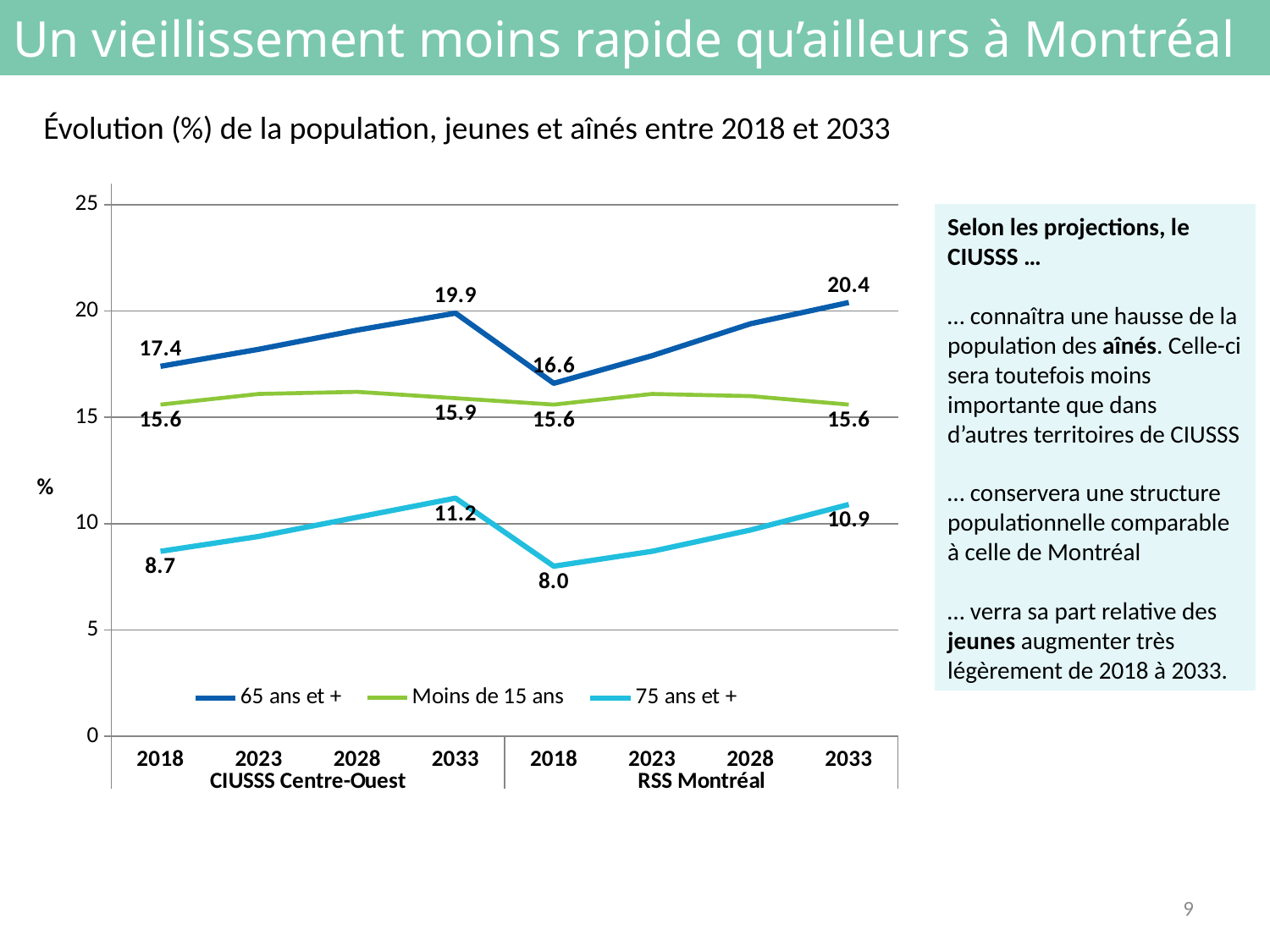
What is the value for 75 ans et + in 2033 for RSS Montréal? 10.9 What is the difference between the 65 ans et + values for CIUSSS Centre-Ouest in 2033 and 2018? 2.5 What is the value for 65 ans et + in 2018 for CIUSSS Centre-Ouest? 17.4 What is the difference between the 75 ans et + values for RSS Montréal in 2033 and 2018? 2.9 What is the title of the chart? Évolution (%) de la population, jeunes et aînés entre 2018 et 2033 What is the value for 65 ans et + in 2018 for RSS Montréal? 16.6 What kind of chart is shown on the slide? Line chart Which is larger, the 65 ans et + value in 2033 for CIUSSS Centre-Ouest or for RSS Montréal? RSS Montréal Does the 65 ans et + series rise or fall from 2018 to 2033 within RSS Montréal? Rise What is the value for Moins de 15 ans in 2033 for CIUSSS Centre-Ouest? 15.9 How many series does the legend list? 3 Is the value for 75 ans et + in 2028 for CIUSSS Centre-Ouest greater or less than 5? greater